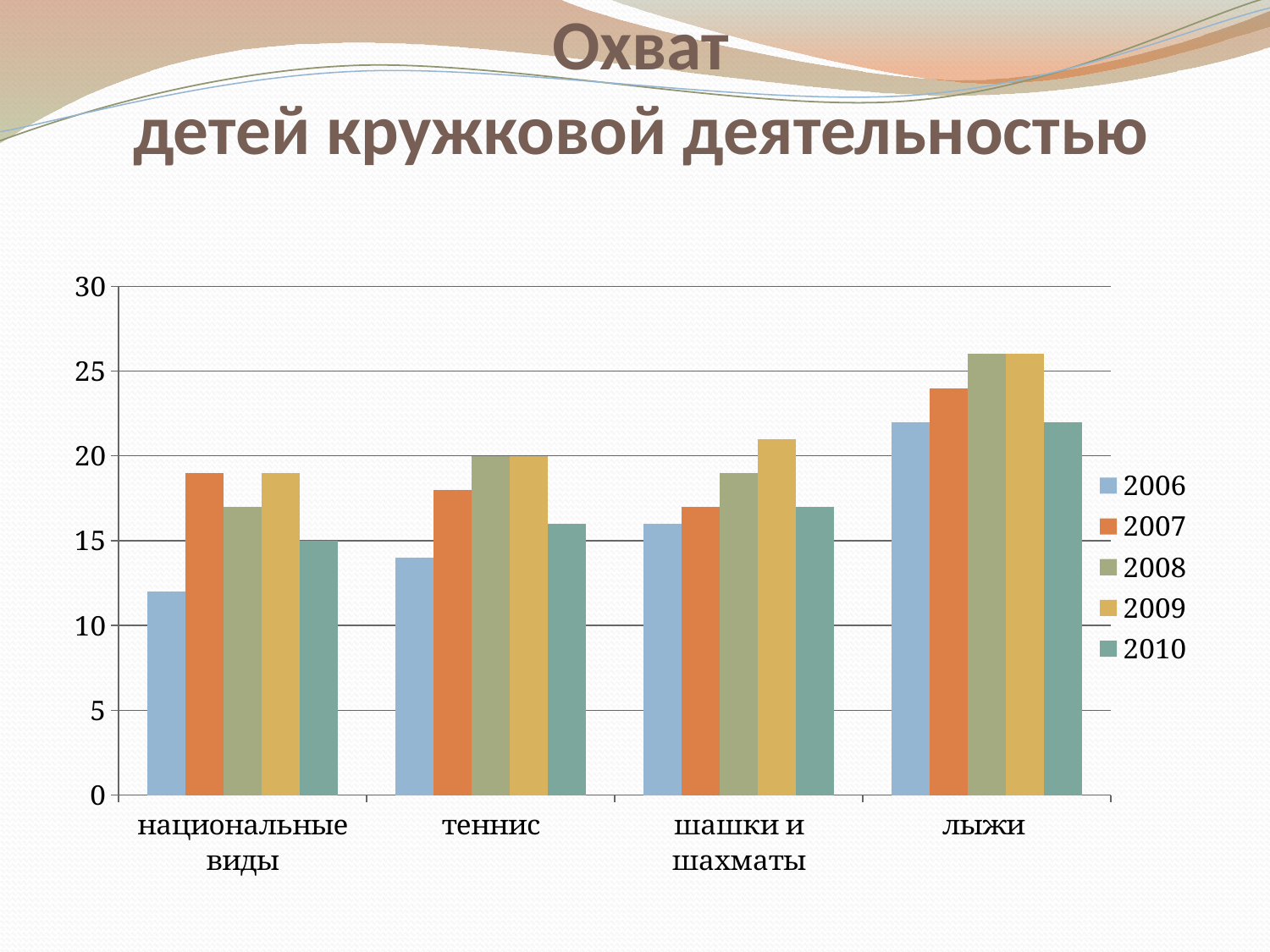
What kind of chart is shown on the slide? bar chart Which category has the lowest value for 2006? национальные виды Which category has the highest value for 2006? лыжи Which year is shown in the legend with the orange colour? 2007 Is the value for лыжи in 2009 greater or less than 25? greater How many series does the legend list? 5 How many categories are shown on the x axis? 4 Which is larger for лыжи: the value for 2007 or the value for 2010? 2007 What is the value for национальные виды in 2010? 15 Is the value for шашки и шахматы in 2009 greater or less than 20? greater Is the value for национальные виды in 2006 greater or less than 15? less What is the value for теннис in 2008? 20